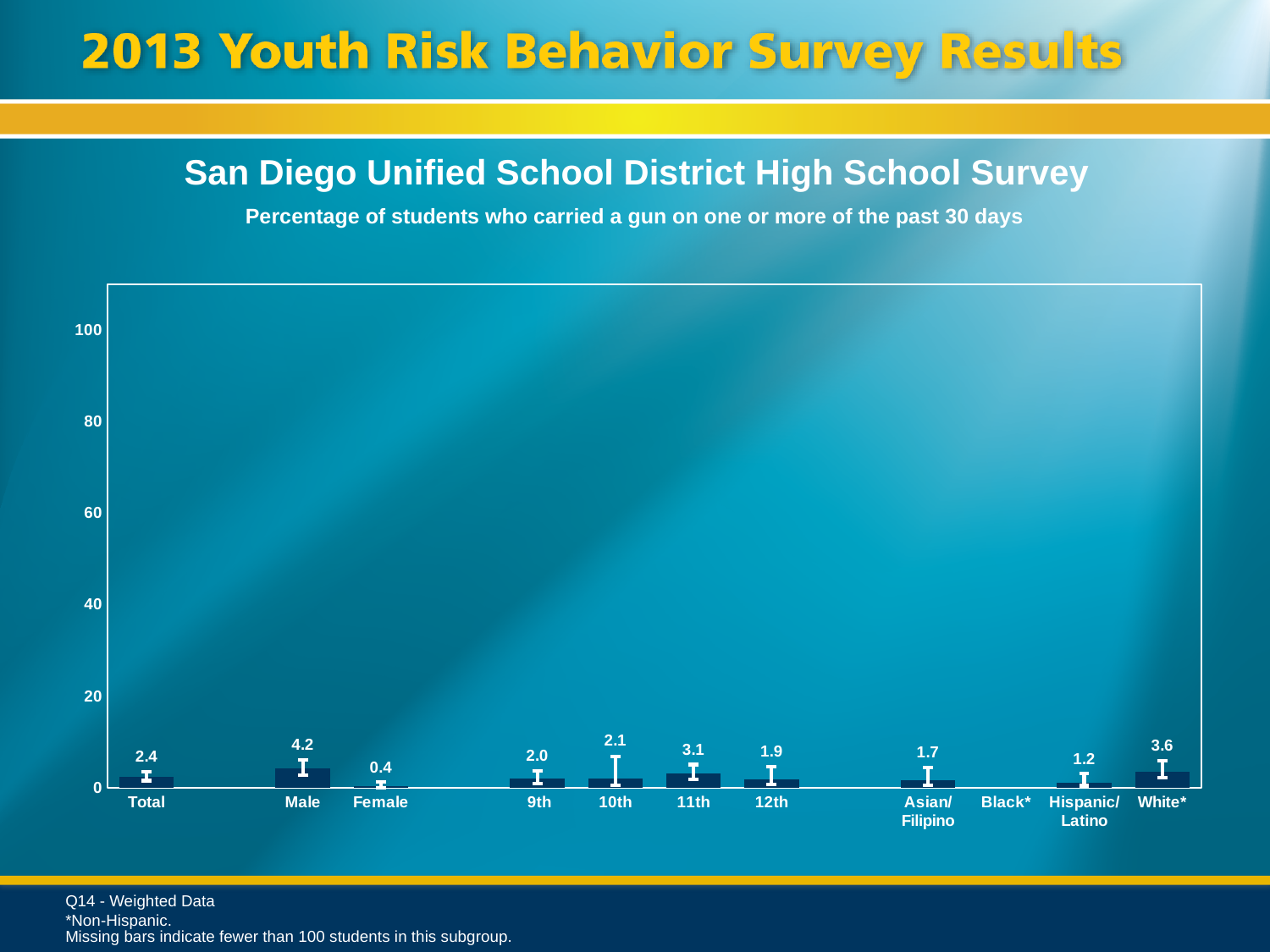
Which category with a plotted bar has the lowest value? Female What is the difference between the Male and Female values? 3.8 Which category has the highest value? Male Which is larger, the value for 10th grade or 12th grade? 10th What kind of chart is shown? bar chart What is the value for Female? 0.4 What is the value for Male? 4.2 What is the value for White*? 3.6 Is the value for Total greater or less than 20? less How many categories are labeled on the x axis? 11 Which category has no bar plotted? Black* What is the value for 11th grade? 3.1